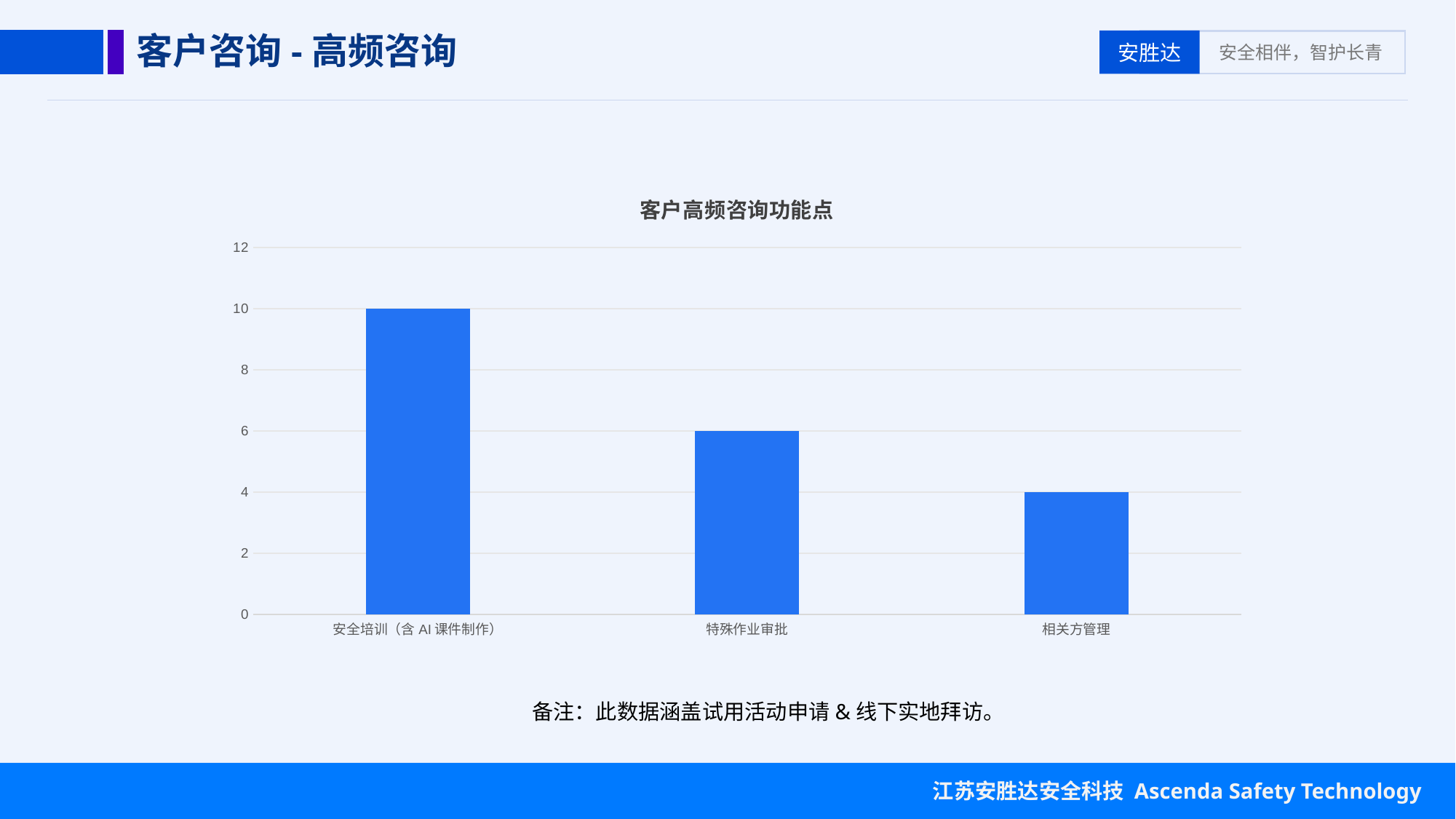
What is the value for 相关方管理? 4 How many categories are shown on the x axis? 3 What is the difference between the values for 特殊作业审批 and 相关方管理? 2 What is the value for 安全培训（含 AI 课件制作）? 10 Which category has the lowest value? 相关方管理 What kind of chart is shown on the slide? bar chart What is the value for 特殊作业审批? 6 What is the title of the chart? 客户高频咨询功能点 What is the difference between the values for 安全培训（含 AI 课件制作） and 特殊作业审批? 4 Which category has the highest value? 安全培训（含 AI 课件制作） Which is larger, the value for 特殊作业审批 or the value for 相关方管理? 特殊作业审批 Is the value for 安全培训（含 AI 课件制作） greater or less than 8? greater